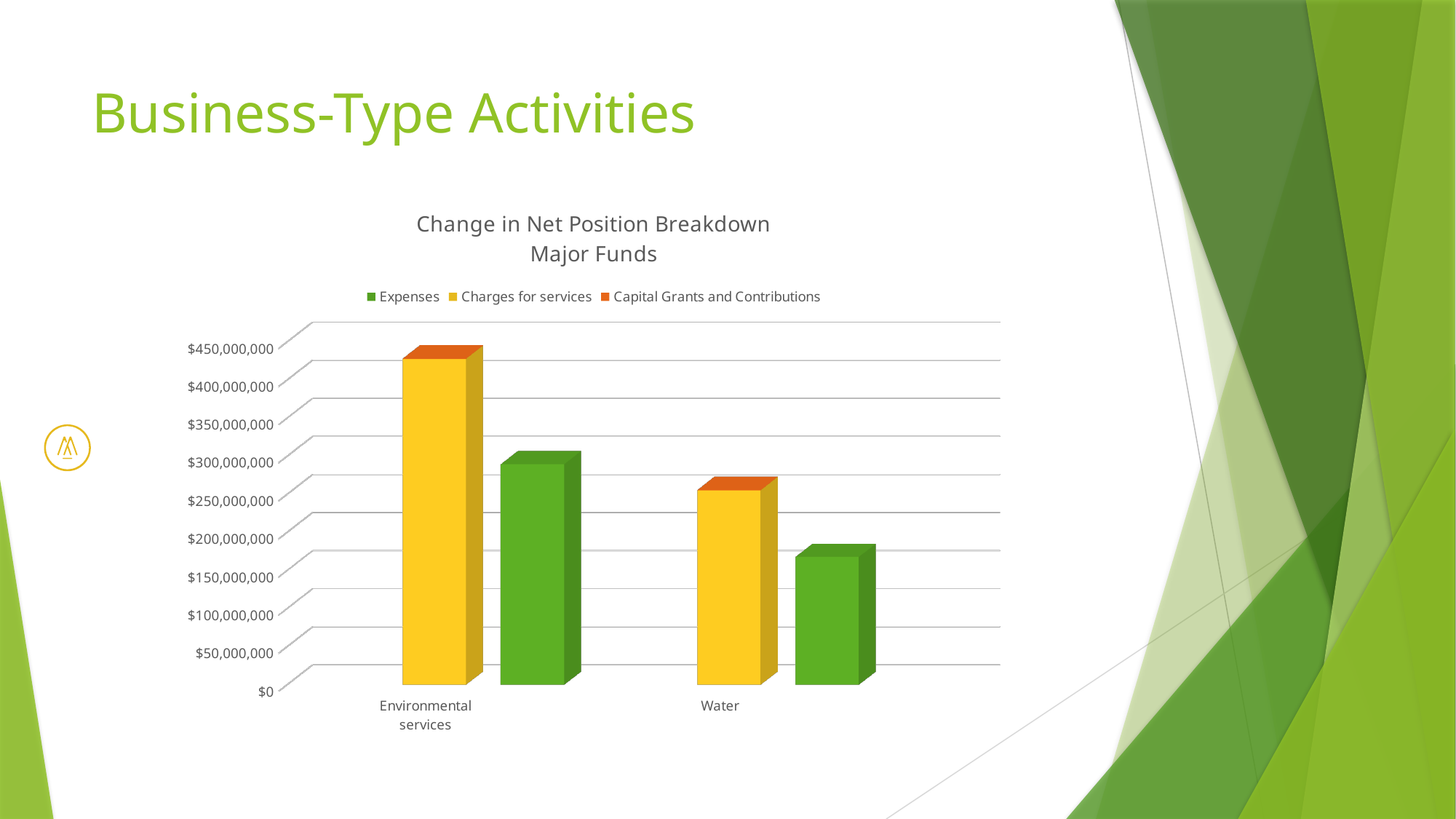
How many categories are shown on the x axis of the chart? 2 Which category has the lowest Expenses value? Water Which category has the higher Charges for services value? Environmental services Is the Charges for services value for Environmental services greater or less than $350,000,000? greater Is the Expenses value for Water greater or less than $200,000,000? less Is the Charges for services value for Water greater or less than $200,000,000? greater Which category has the higher Expenses value, Environmental services or Water? Environmental services What is the title of the chart? Change in Net Position Breakdown Major Funds What type of chart is shown on the slide? bar chart How many series does the chart legend list? 3 Which colour represents Expenses in the chart? green